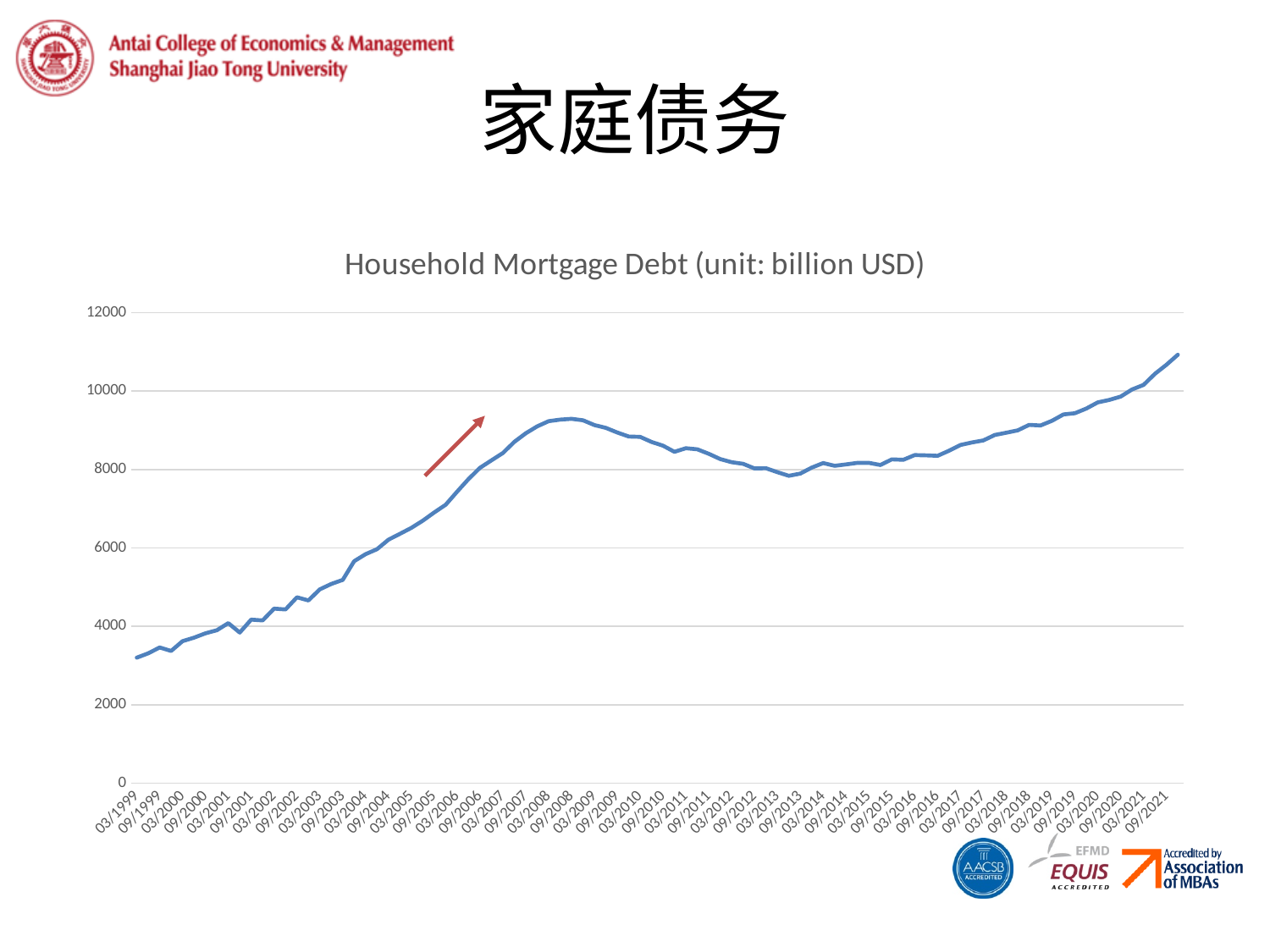
Is the value for 09/2021 greater or less than 10000? greater What unit is the household mortgage debt measured in, according to the chart title? billion USD Which is larger, the value for 03/2008 or the value for 03/2013? 03/2008 Is the value for 03/2005 greater or less than 6000? greater Is the value for 03/2008 greater or less than 8000? greater What is the title of the chart? Household Mortgage Debt (unit: billion USD) What kind of chart is shown on the slide? Line chart Does the line generally rise or fall between 03/2008 and 03/2013? fall At which date on the x axis does the line have its lowest value? 03/1999